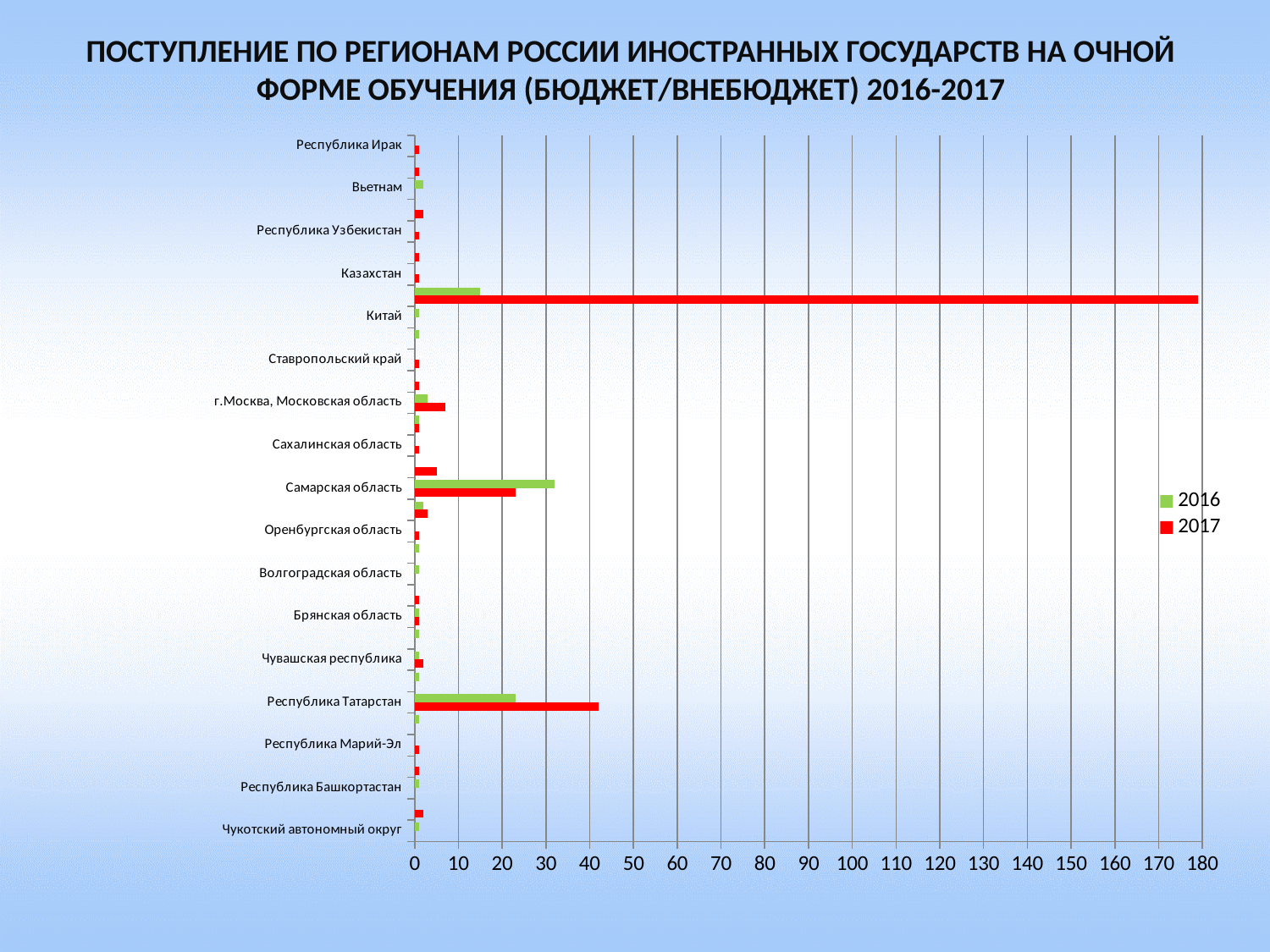
What kind of chart is shown on the slide? bar chart How many series does the legend list? 2 Which has the larger 2017 value, Республика Татарстан or Самарская область? Республика Татарстан For Самарская область, which year has the larger value, 2016 or 2017? 2016 Which years are listed in the legend? 2016 and 2017 Is the 2016 value for Республика Татарстан greater or less than 10? greater What colour represents the 2017 series? red Is the 2017 value for г.Москва, Московская область greater or less than 20? less Is the 2016 value for Самарская область greater or less than 20? greater For Республика Татарстан, which year has the larger value, 2016 or 2017? 2017